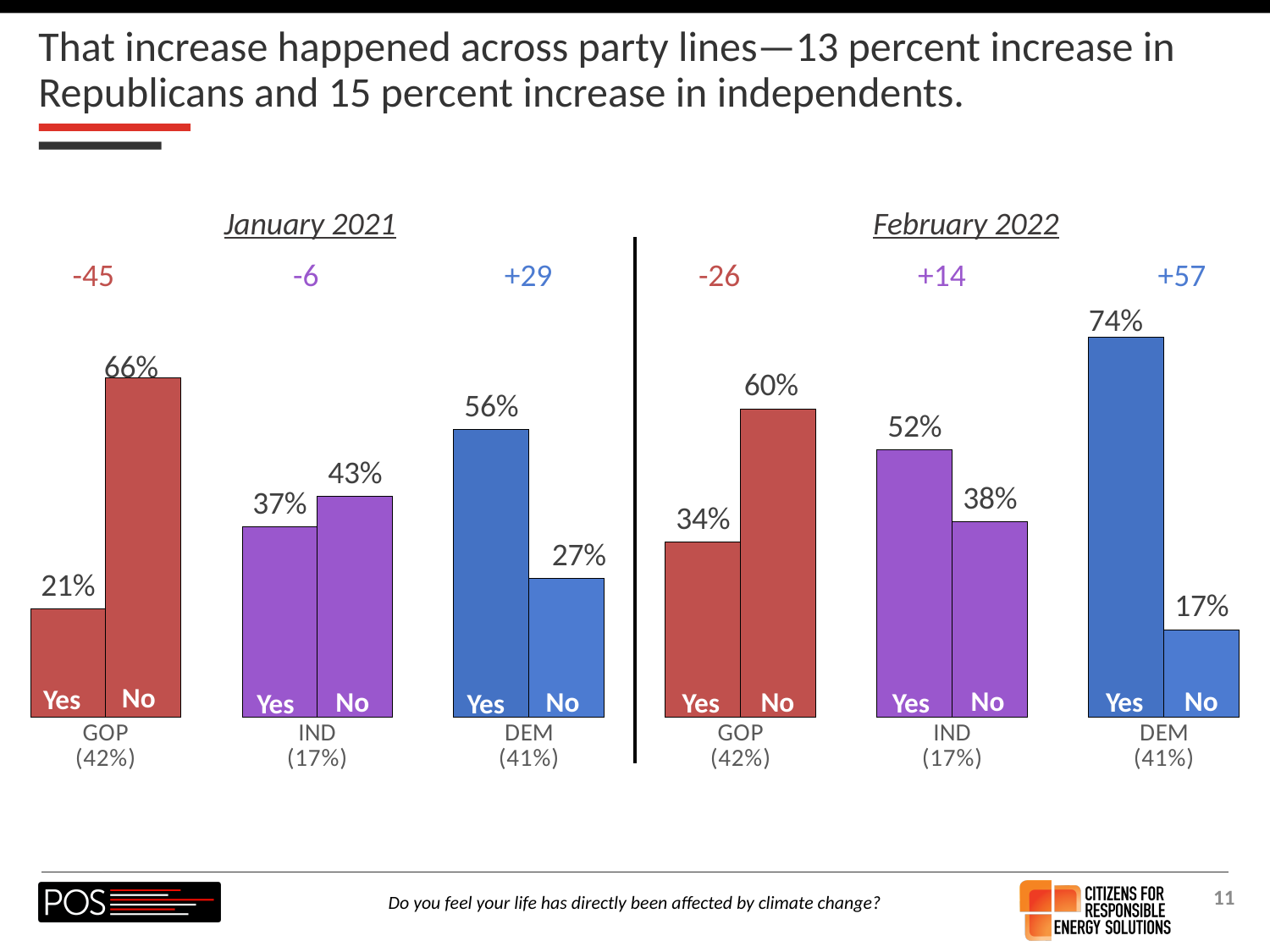
In the January 2021 chart, what is the difference between the IND No and IND Yes percentages? 6 percentage points In the February 2022 chart, what percentage of DEM respondents answered Yes? 74% In the February 2022 chart, which party group has the lowest Yes percentage? GOP In the February 2022 chart, is the IND Yes percentage larger or smaller than the IND No percentage? larger In the January 2021 chart, is the GOP Yes percentage larger or smaller than the DEM No percentage? smaller In the February 2022 chart, what net figure is shown above the DEM bars? +57 What is the difference between the DEM Yes percentage in February 2022 and the DEM Yes percentage in January 2021? 18 percentage points How many party groups are shown in the February 2022 chart? 3 In the January 2021 chart, what percentage of GOP respondents answered Yes? 21% In the January 2021 chart, which party group has the highest No percentage? GOP In the February 2022 chart, what percentage of IND respondents answered No? 38% What kind of chart is used to show the January 2021 results? bar chart